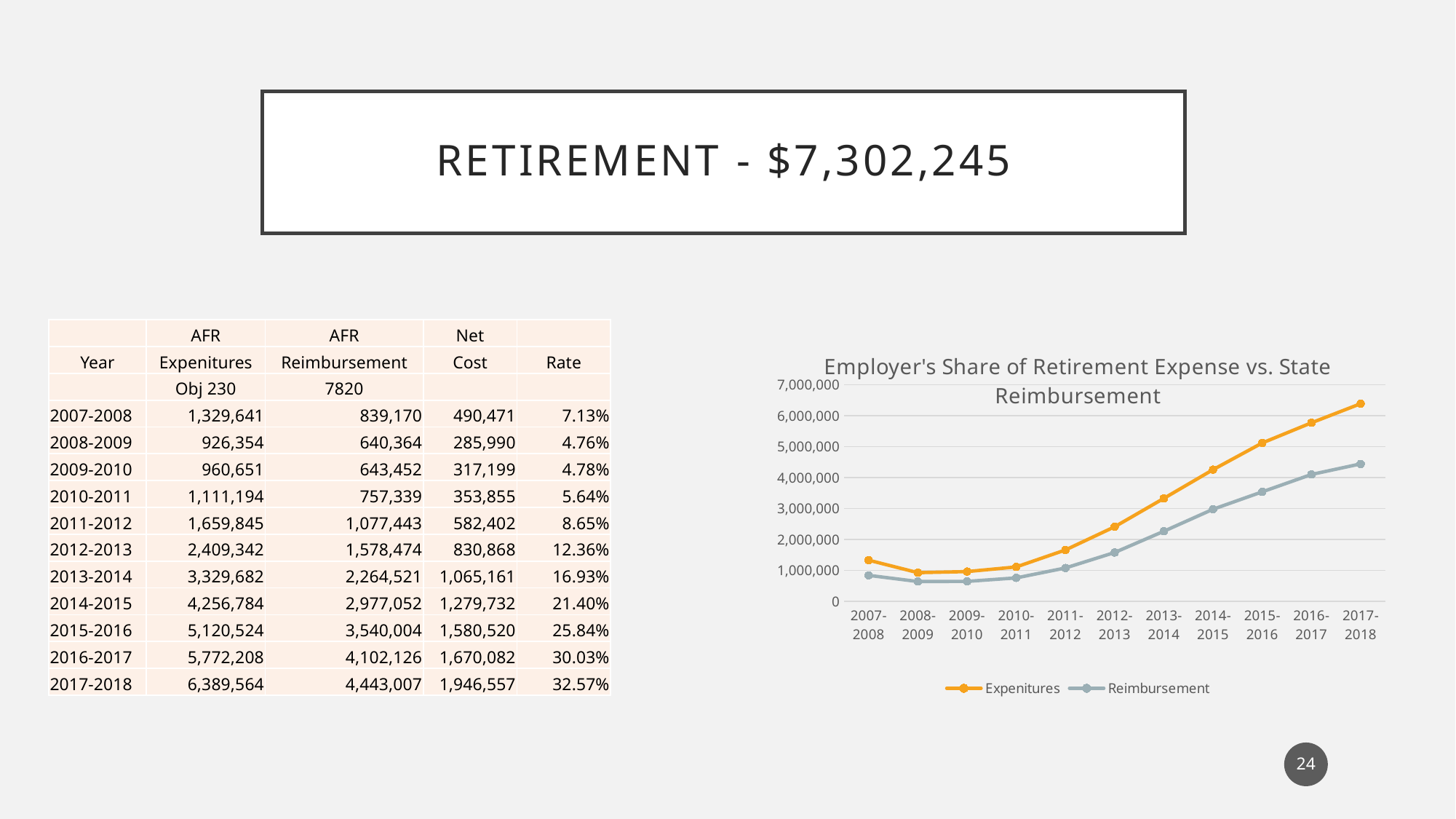
What is the Reimbursement value for 2017-2018, as printed in the table on the slide? 4,443,007 Which is larger in 2014-2015, Expenitures or Reimbursement? Expenitures Which year has the lowest Reimbursement value in the chart? 2008-2009 How many years are plotted along the x axis of the chart? 11 Is the Expenitures value for 2015-2016 greater or less than 5,000,000? greater What kind of chart is shown on the slide? line chart Is the Reimbursement value for 2013-2014 greater or less than 3,000,000? less What is the title of the chart? Employer's Share of Retirement Expense vs. State Reimbursement Which year has the highest Expenitures value in the chart? 2017-2018 How many series does the chart's legend list? 2 What are the two series named in the chart's legend? Expenitures and Reimbursement Do the Expenitures values generally rise or fall from 2010-2011 to 2017-2018? rise